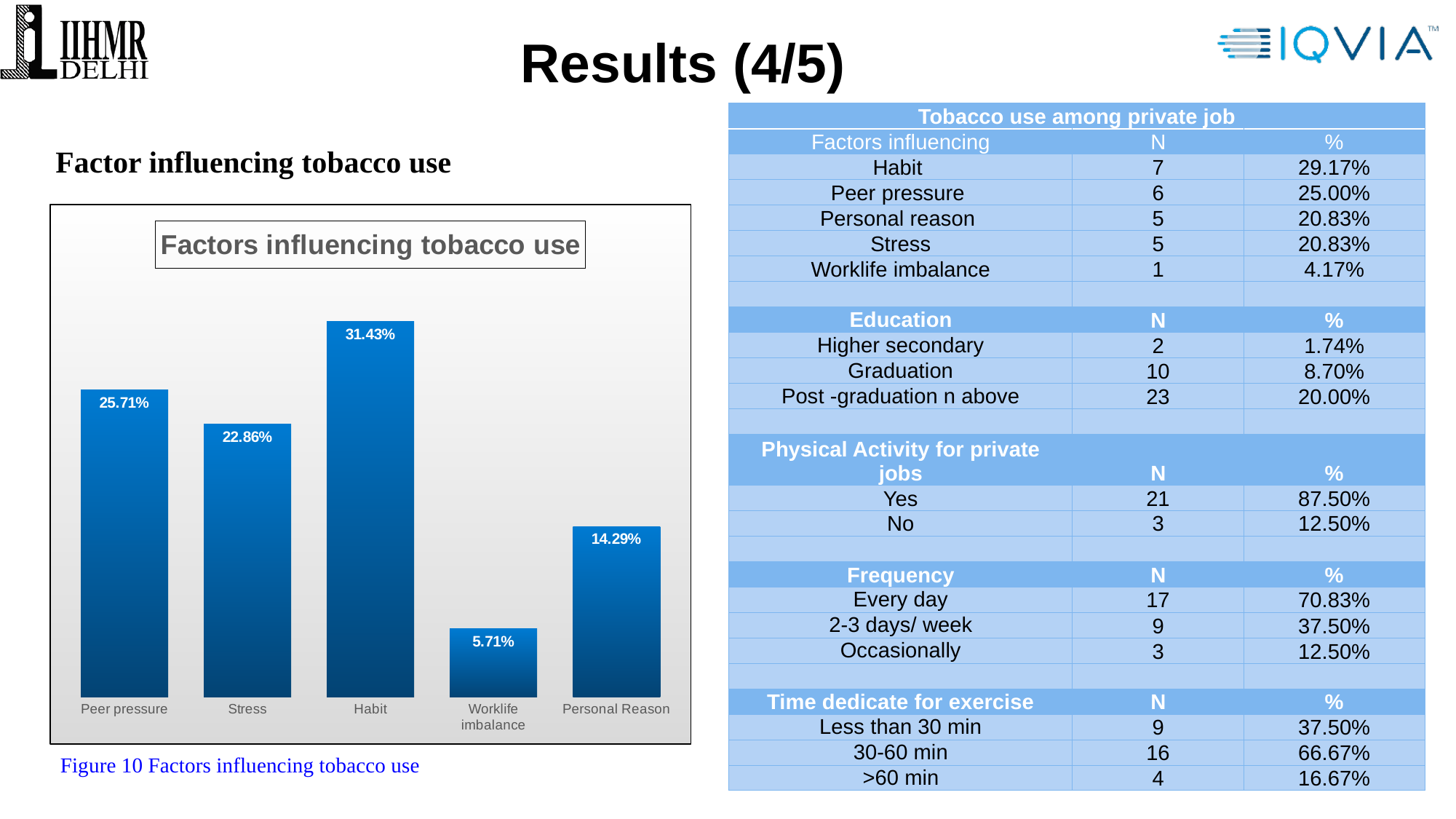
What kind of chart is the Factors influencing tobacco use chart? Bar chart What is the difference between the values for Habit and Stress in the Factors influencing tobacco use chart? 8.57% Which category has the highest value in the Factors influencing tobacco use chart? Habit What is the value for Worklife imbalance in the Factors influencing tobacco use chart? 5.71% What is the value for Habit in the Factors influencing tobacco use chart? 31.43% Which is larger in the Factors influencing tobacco use chart, Peer pressure or Personal Reason? Peer pressure How many categories are shown in the Factors influencing tobacco use chart? 5 What is the value for Personal Reason in the Factors influencing tobacco use chart? 14.29% What is the value for Peer pressure in the Factors influencing tobacco use chart? 25.71% What is the title of the chart on the slide? Factors influencing tobacco use What is the difference between the values for Stress and Worklife imbalance in the Factors influencing tobacco use chart? 17.15% Which category has the lowest value in the Factors influencing tobacco use chart? Worklife imbalance